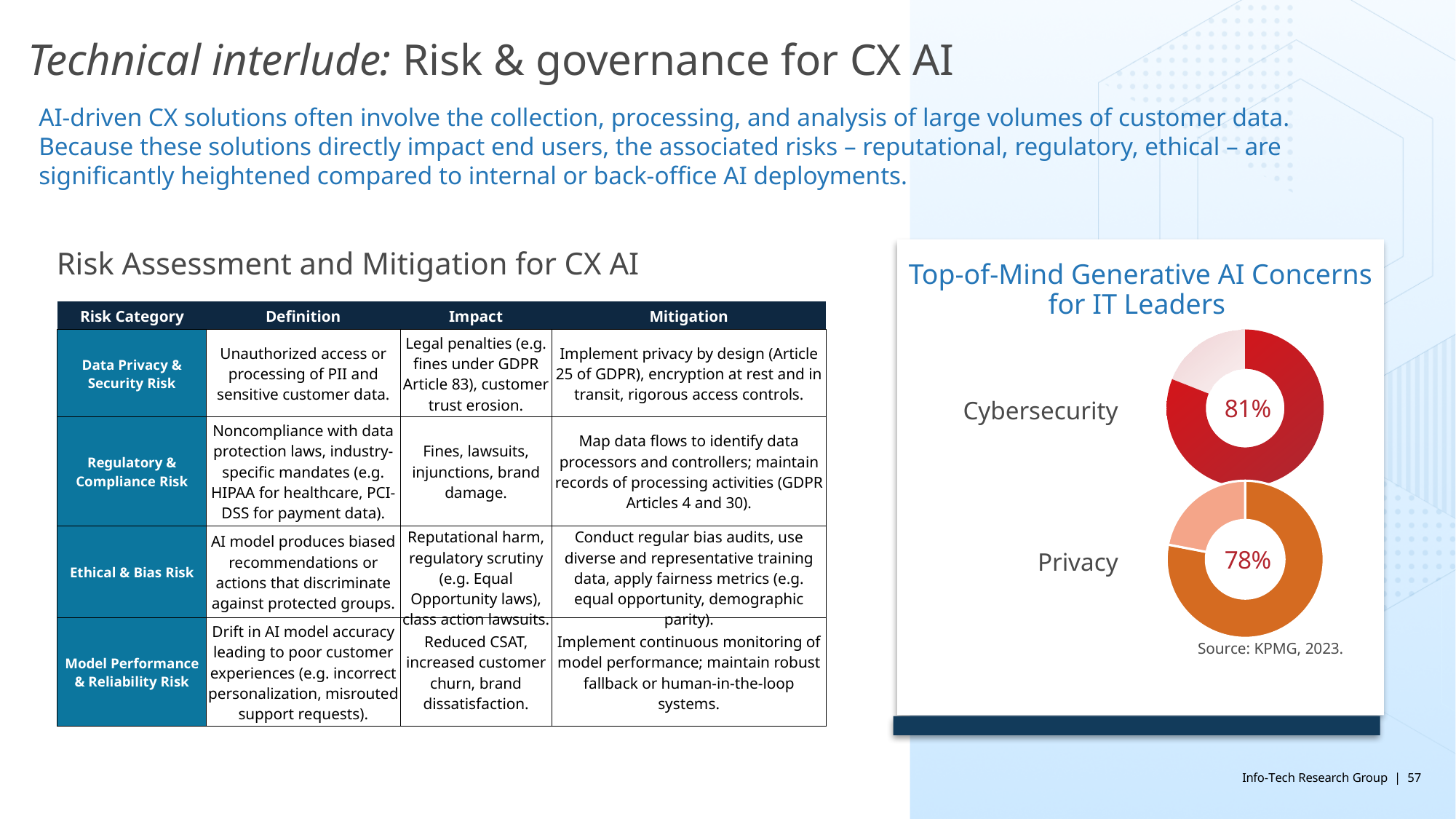
Of the two donut charts under 'Top-of-Mind Generative AI Concerns for IT Leaders', which concern has the higher percentage? Cybersecurity Is the value in the Cybersecurity donut chart larger or smaller than the value in the Privacy donut chart? larger What is the title above the two donut charts on the right of the slide? Top-of-Mind Generative AI Concerns for IT Leaders What source is cited beneath the donut charts? KPMG, 2023 Of the two donut charts under 'Top-of-Mind Generative AI Concerns for IT Leaders', which concern has the lower percentage? Privacy What type of chart is used to show the Cybersecurity and Privacy concerns? Donut (pie) chart How many donut charts are shown under the title 'Top-of-Mind Generative AI Concerns for IT Leaders'? 2 In the Privacy donut chart, what share of the ring is filled by the orange segment? 78% What is the difference in percentage points between the Cybersecurity donut chart value and the Privacy donut chart value? 3 percentage points In the Cybersecurity donut chart, what share of the ring is filled by the dark red segment? 81% In the Privacy donut chart, what percentage is shown in the centre? 78% In the Cybersecurity donut chart, what percentage is shown in the centre? 81%